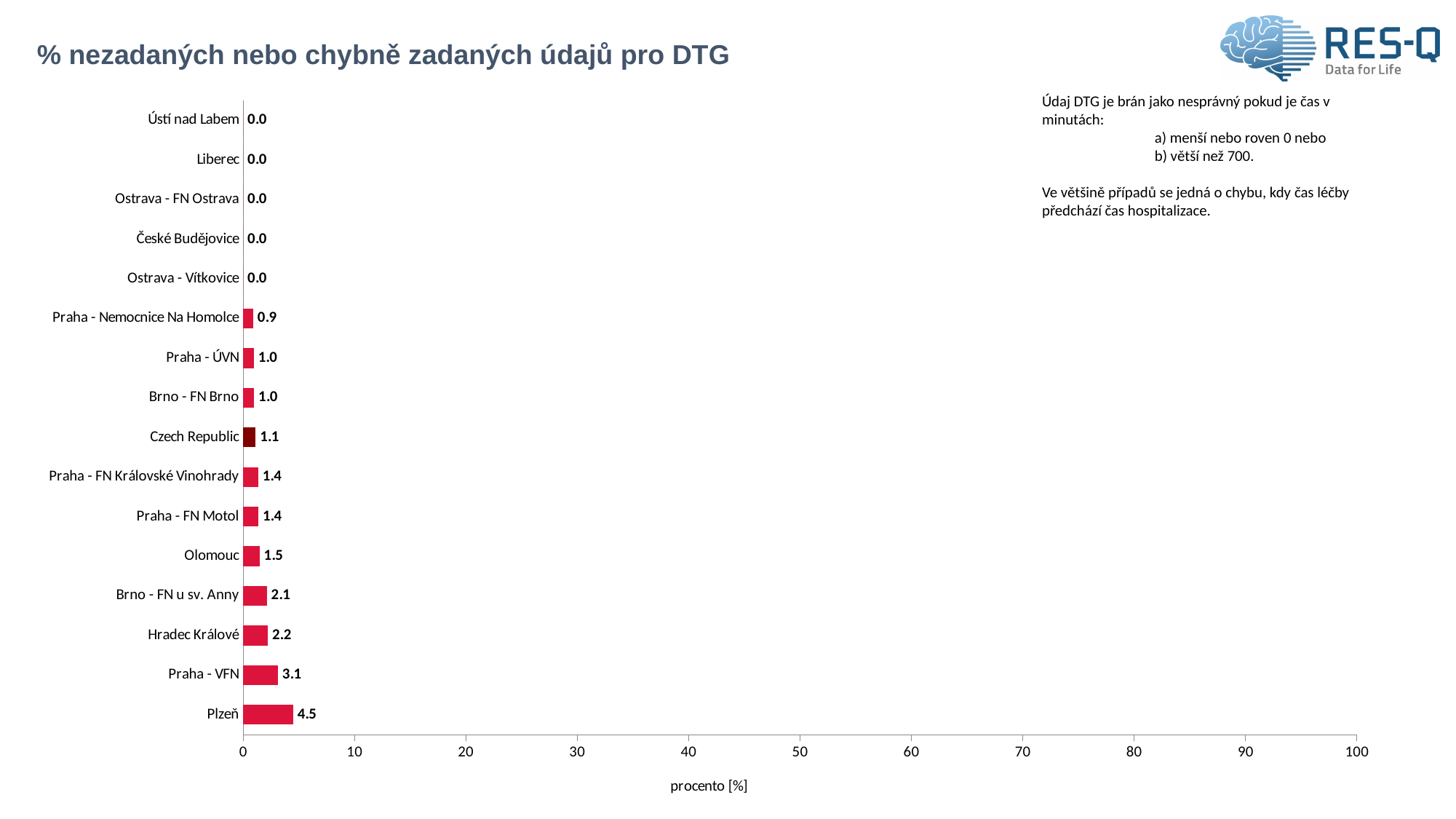
Is the value for Plzeň greater or less than 10? less Which is larger, the value for Olomouc or the value for Brno - FN u sv. Anny? Brno - FN u sv. Anny How many categories have a value of 0.0? 5 What kind of chart is shown on the slide? bar chart What is the difference between the values for Plzeň and Praha - VFN? 1.4 What is the value for Plzeň? 4.5 How many categories are shown on the chart? 16 What is the value for Hradec Králové? 2.2 What is the label of the horizontal axis? procento [%] What is the value for Praha - VFN? 3.1 Which category has the highest value? Plzeň What is the value for Czech Republic? 1.1